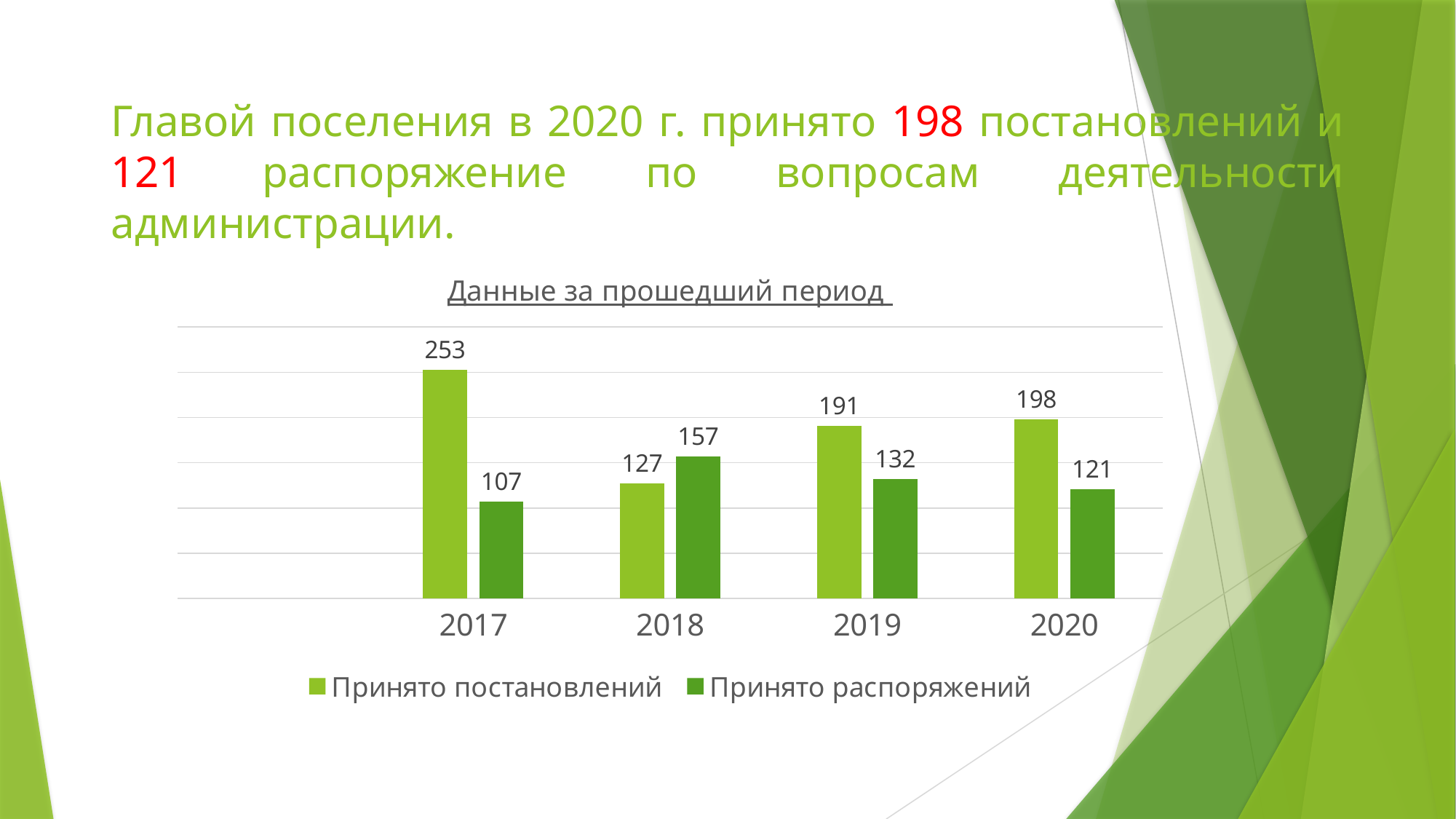
What is the difference between "Принято постановлений" and "Принято распоряжений" in 2019? 59 Which year has the highest value for "Принято постановлений"? 2017 In 2018, which is larger: "Принято постановлений" or "Принято распоряжений"? Принято распоряжений What kind of chart is shown on the slide? Bar chart What is the title of the chart? Данные за прошедший период What is the value for "Принято распоряжений" in 2018? 157 How many series does the legend list? 2 How many years are shown on the x axis? 4 What is the value for "Принято постановлений" in 2017? 253 Which year has the lowest value for "Принято распоряжений"? 2017 What is the difference between "Принято постановлений" in 2017 and in 2018? 126 What is the value for "Принято постановлений" in 2020? 198